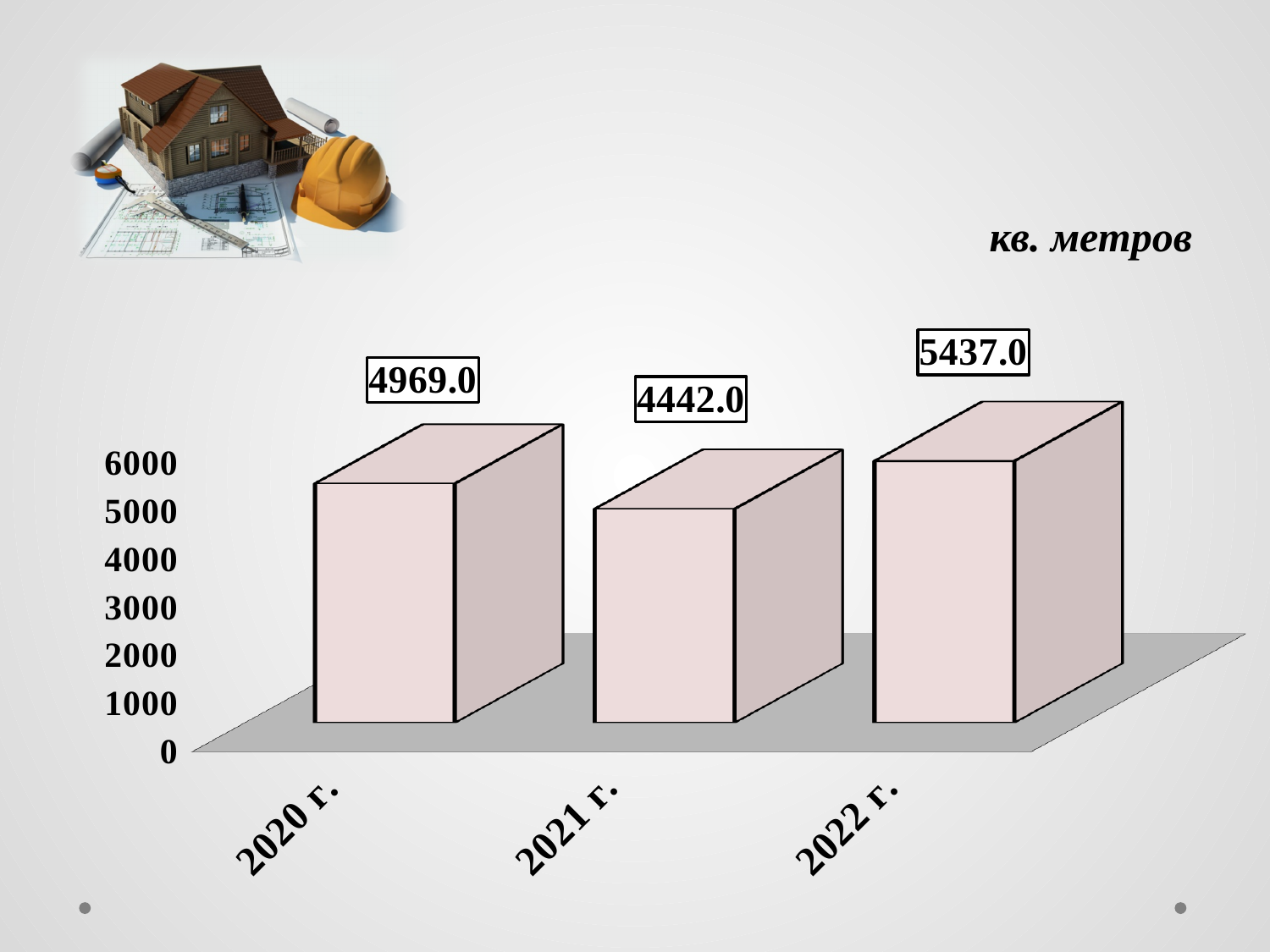
Which is larger, the value for 2020 г. or the value for 2022 г.? 2022 г. What is the value for 2020 г.? 4969.0 How many years are shown on the chart? 3 Is the value for 2021 г. greater or less than 5000? less What kind of chart is shown on the slide? bar chart Which year has the highest value? 2022 г. Which year has the lowest value? 2021 г. What is the value for 2021 г.? 4442.0 What is the difference between the values for 2020 г. and 2021 г.? 527.0 What is the difference between the values for 2022 г. and 2021 г.? 995.0 What unit label is shown above the chart? кв. метров What is the value for 2022 г.? 5437.0